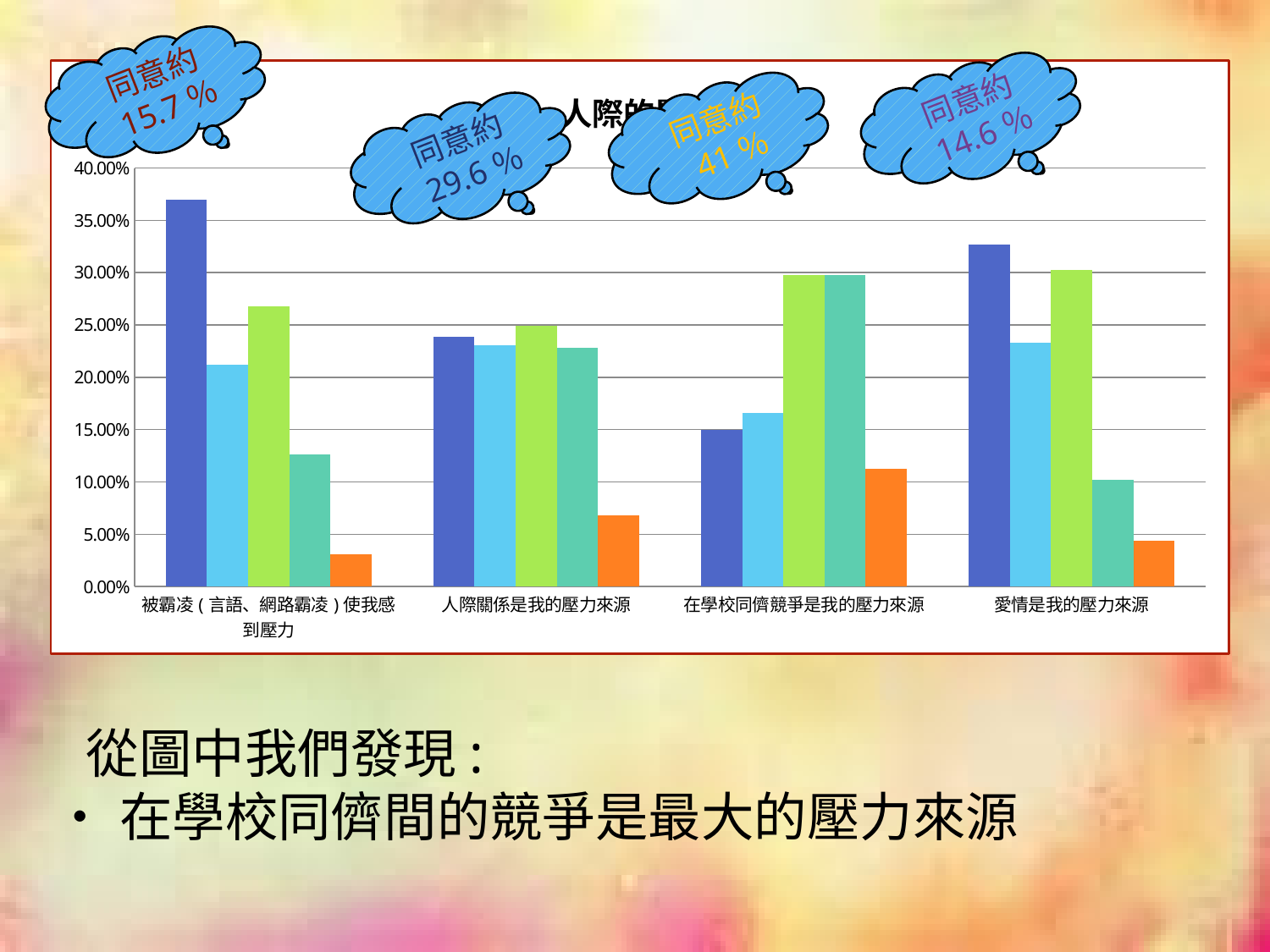
Is the orange bar for 被霸凌（言語、網路霸凌）使我感到壓力 greater or less than 5.00%? less Is the orange bar for 在學校同儕競爭是我的壓力來源 greater or less than 10.00%? greater For 在學校同儕競爭是我的壓力來源, which is taller: the dark blue bar or the light blue bar? the light blue bar Which category has the tallest dark blue bar? 被霸凌（言語、網路霸凌）使我感到壓力 Is the dark blue bar for 被霸凌（言語、網路霸凌）使我感到壓力 greater or less than 35.00%? greater Which category has the shortest teal bar? 愛情是我的壓力來源 According to the cloud callout above 在學校同儕競爭是我的壓力來源, about what percentage agree? 41 % How many bars are plotted for each category on the chart? 5 Which category has the tallest orange bar? 在學校同儕競爭是我的壓力來源 What kind of chart is shown on the slide? bar chart How many categories are shown on the x axis of the chart? 4